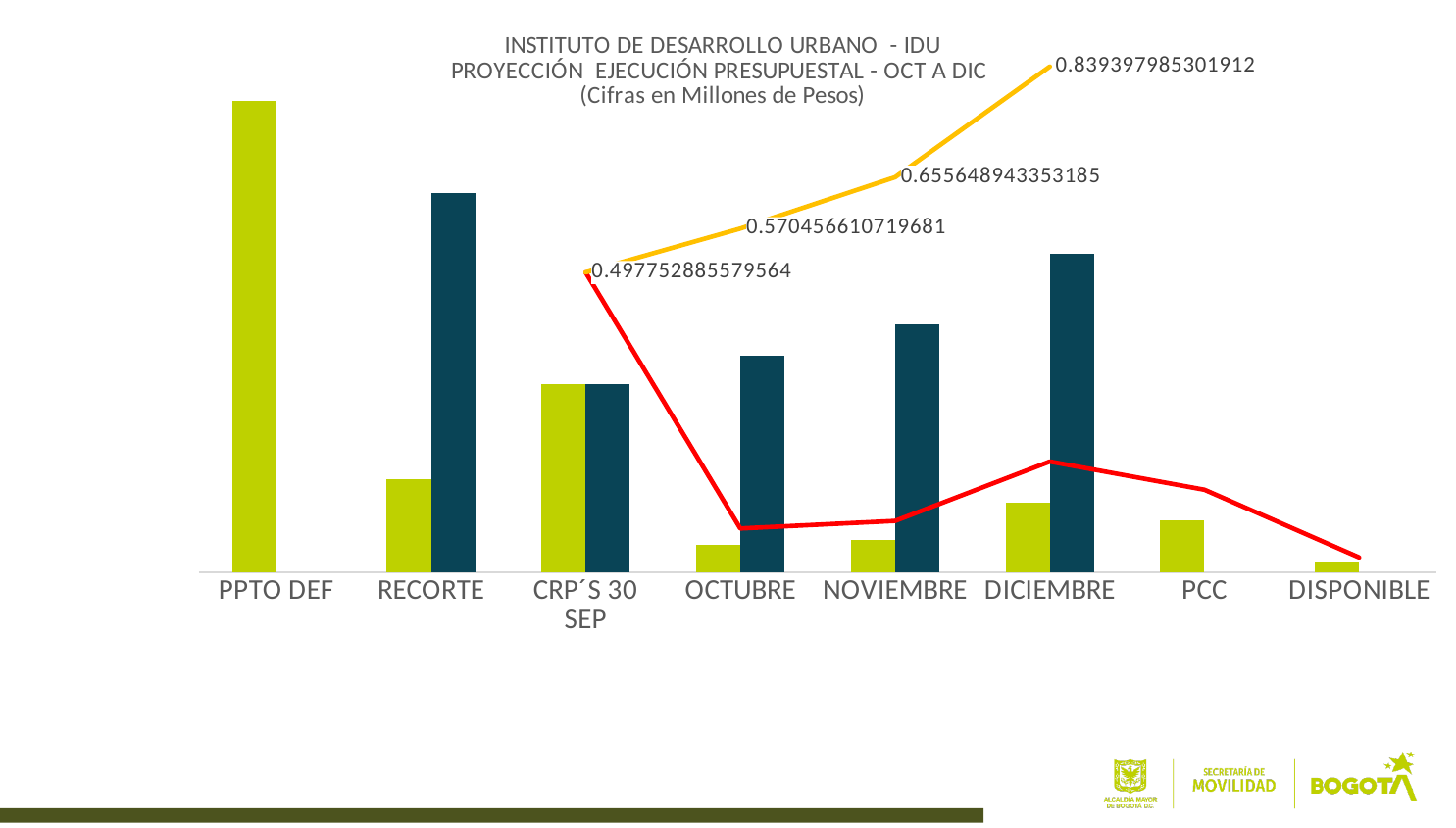
Do the labelled values on the orange line rise or fall from CRP´S 30 SEP to DICIEMBRE? rise Which category has the highest labelled value on the orange line? DICIEMBRE What value is labelled on the orange line at CRP´S 30 SEP? 0.497752885579564 How many categories are shown on the x axis? 8 Is the light green bar for RECORTE taller or shorter than the light green bar for OCTUBRE? taller What value is labelled on the orange line at OCTUBRE? 0.570456610719681 What is the difference between the orange line's labelled values at DICIEMBRE and NOVIEMBRE? 0.183749041948727 What value is labelled on the orange line at DICIEMBRE? 0.839397985301912 What value is labelled on the orange line at NOVIEMBRE? 0.655648943353185 Which category has the tallest dark teal bar? RECORTE Which category has the tallest light green bar? PPTO DEF What kind of chart is shown on the slide? A combination bar and line chart